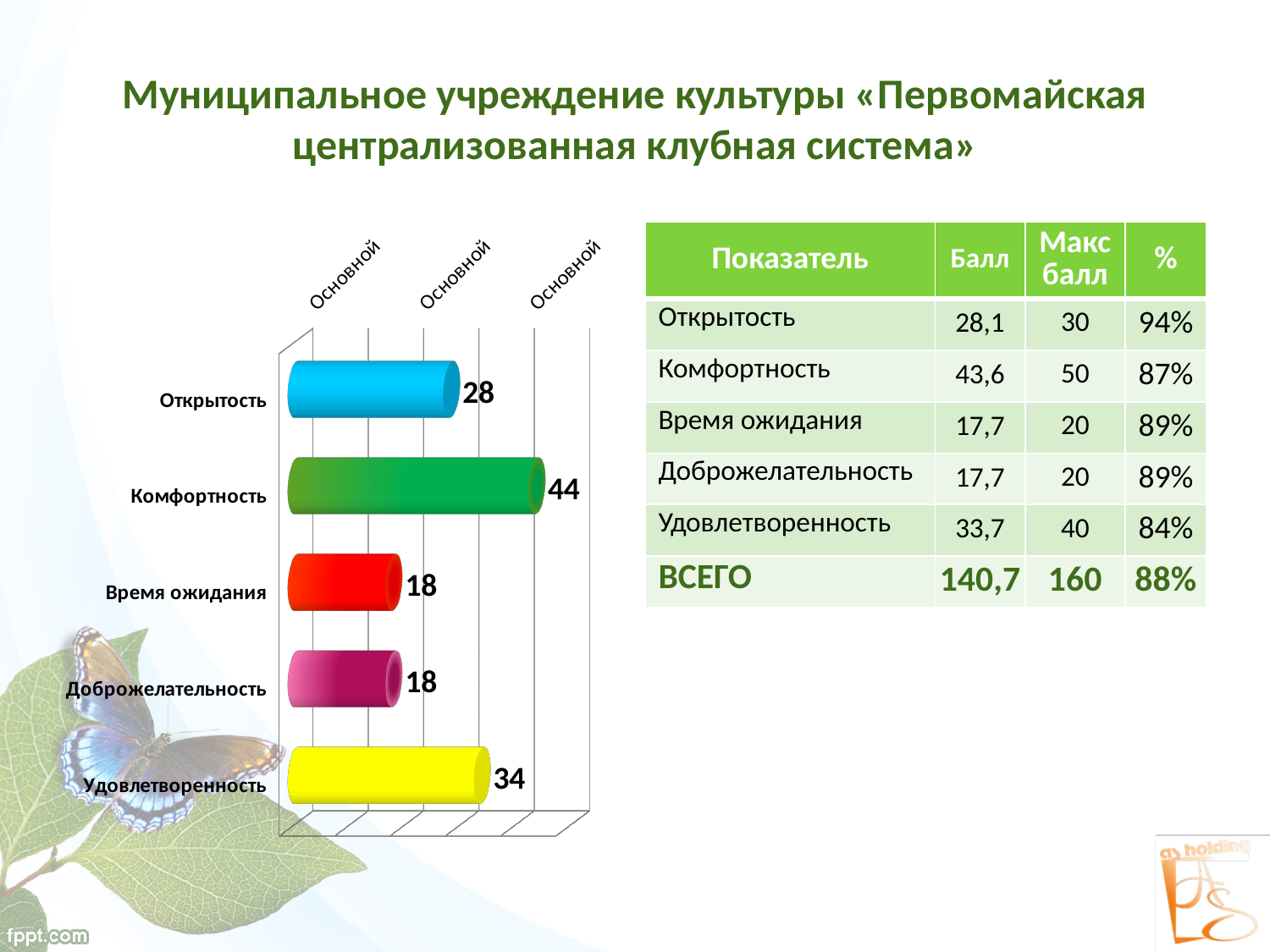
Which categories share the lowest value in the chart? Время ожидания and Доброжелательность What is the difference between the values for Комфортность and Открытость? 16 What value is shown for Открытость in the chart? 28 What is the difference between the values for Удовлетворенность and Доброжелательность? 16 Which category has the highest value in the chart? Комфортность What value is shown for Время ожидания in the chart? 18 What value is shown for Комфортность in the chart? 44 What colour is the bar for Удовлетворенность? Yellow What kind of chart is shown on the slide? Bar chart What value is shown for Удовлетворенность in the chart? 34 Which is larger, the value for Открытость or the value for Удовлетворенность? Удовлетворенность How many categories are plotted in the chart? 5